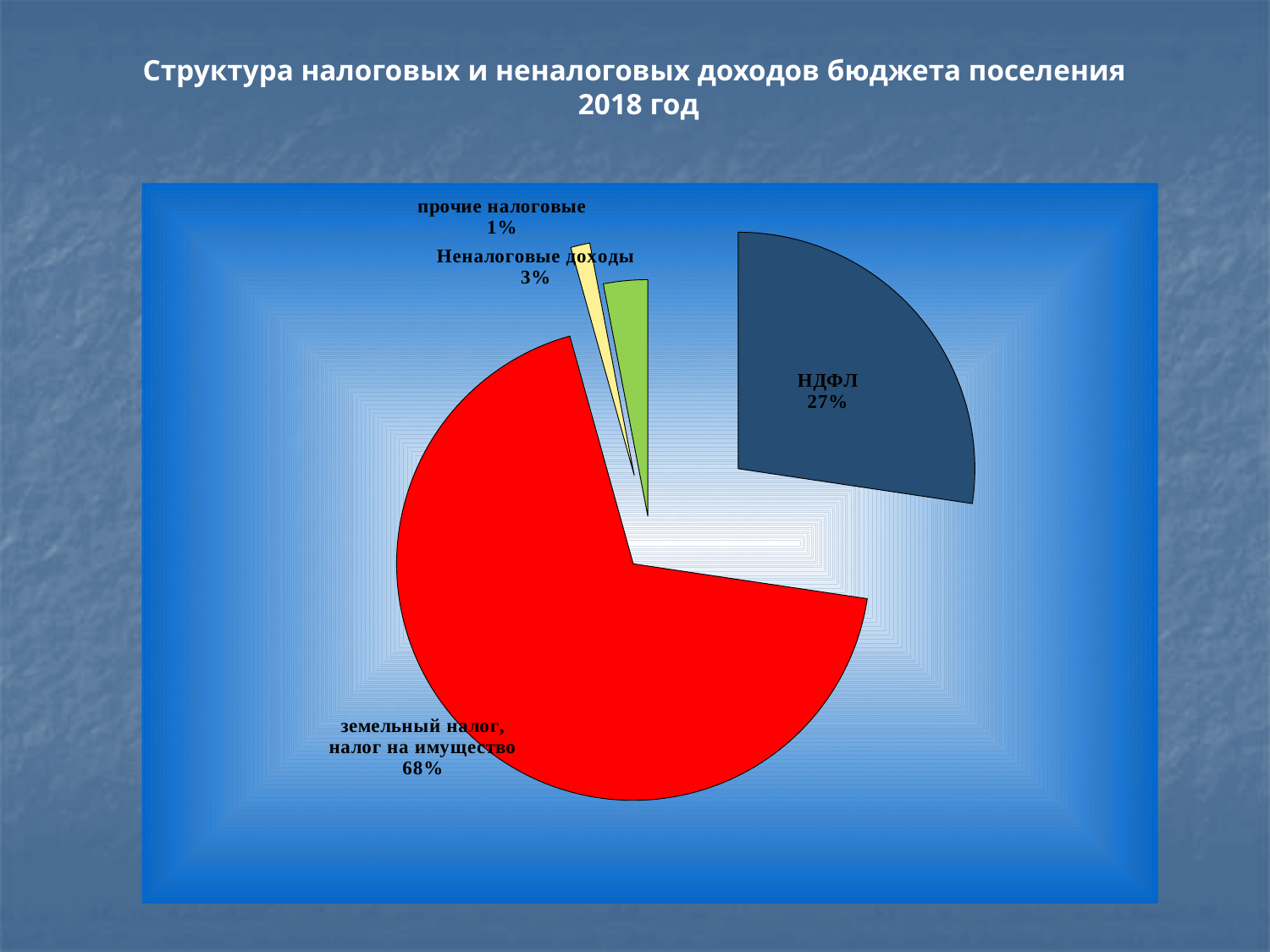
What kind of chart is shown on the slide? pie chart What is the value shown for прочие налоговые? 1% Which category has the largest slice of the pie? земельный налог, налог на имущество What is the difference in percentage points between земельный налог, налог на имущество and НДФЛ? 41 What share of the pie does НДФЛ represent? 27% Which category has the smallest slice of the pie? прочие налоговые What is the title of the slide? Структура налоговых и неналоговых доходов бюджета поселения 2018 год Which is larger, the share for НДФЛ or the share for Неналоговые доходы? НДФЛ What colour is the slice for земельный налог, налог на имущество? red What is the value shown for Неналоговые доходы? 3% What share of the pie does земельный налог, налог на имущество represent? 68% How many slices does the pie chart have? 4